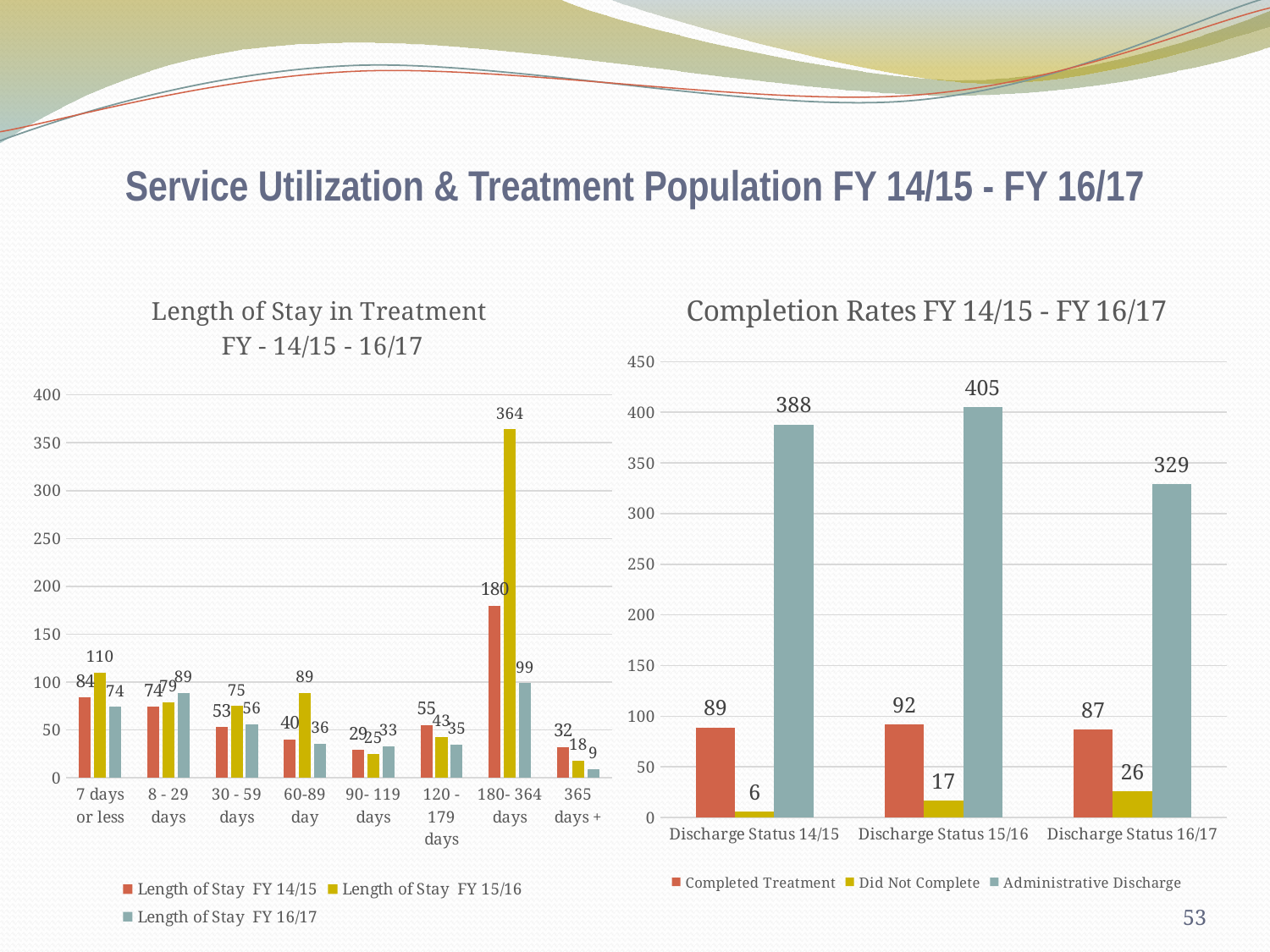
In the Length of Stay in Treatment chart, how many length-of-stay categories are shown on the x axis? 8 In the Length of Stay in Treatment chart, what is the value for Length of Stay FY 16/17 in the 365 days + category? 9 In the Length of Stay in Treatment chart, what is the difference between Length of Stay FY 15/16 and Length of Stay FY 14/15 in the 180-364 days category? 184 What kind of chart is the Completion Rates FY 14/15 - FY 16/17 chart? Bar chart In the Length of Stay in Treatment chart, which is larger in the 60-89 day category: Length of Stay FY 14/15 or Length of Stay FY 15/16? Length of Stay FY 15/16 In the Completion Rates FY 14/15 - FY 16/17 chart, what is the difference between Administrative Discharge in Discharge Status 15/16 and Discharge Status 16/17? 76 In the Length of Stay in Treatment chart, which category has the lowest Length of Stay FY 14/15 value? 90-119 days In the Completion Rates FY 14/15 - FY 16/17 chart, what is the value for Administrative Discharge in Discharge Status 15/16? 405 In the Completion Rates FY 14/15 - FY 16/17 chart, what is the value for Did Not Complete in Discharge Status 14/15? 6 In the Completion Rates FY 14/15 - FY 16/17 chart, which discharge status year has the highest Completed Treatment value? Discharge Status 15/16 In the Length of Stay in Treatment chart, what is the value for Length of Stay FY 15/16 in the 180-364 days category? 364 In the Completion Rates FY 14/15 - FY 16/17 chart, how many series does the legend list? 3